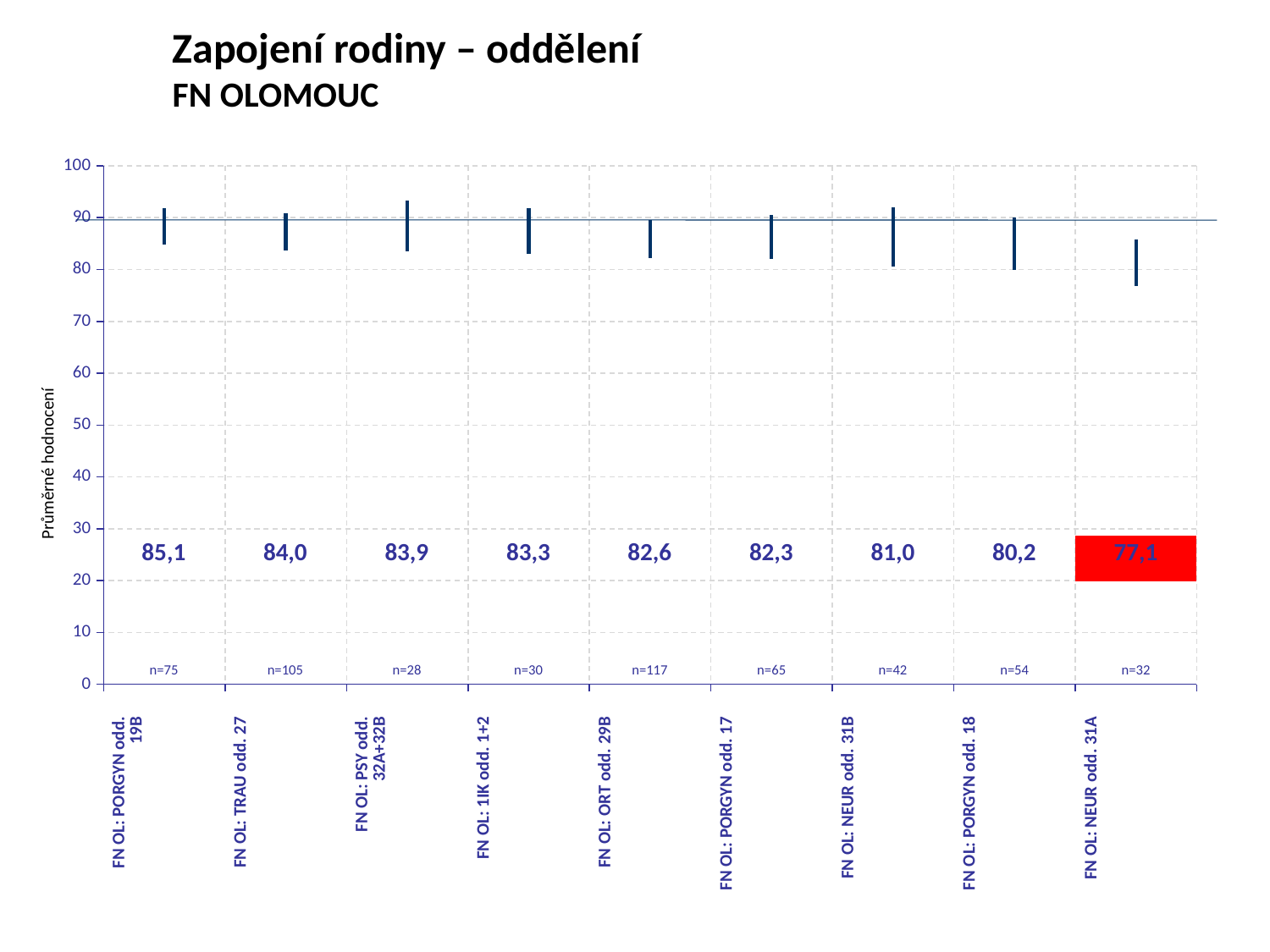
What is the average rating for FN OL: ORT odd. 29B? 82,6 Which department has the lowest average rating? FN OL: NEUR odd. 31A Which department's value label is highlighted with a red background? FN OL: NEUR odd. 31A What is the average rating for FN OL: NEUR odd. 31A? 77,1 Which department has the highest average rating? FN OL: PORGYN odd. 19B What is the number of respondents (n) for FN OL: PSY odd. 32A+32B? n=28 How many departments are shown on the chart? 9 What is the number of respondents (n) for FN OL: ORT odd. 29B? n=117 Do the average ratings rise or fall from left to right along the x axis? fall Which has a higher average rating, FN OL: TRAU odd. 27 or FN OL: PORGYN odd. 18? FN OL: TRAU odd. 27 What is the difference between the average ratings of FN OL: PORGYN odd. 19B and FN OL: NEUR odd. 31A? 8,0 What is the average rating (průměrné hodnocení) for FN OL: PORGYN odd. 19B? 85,1